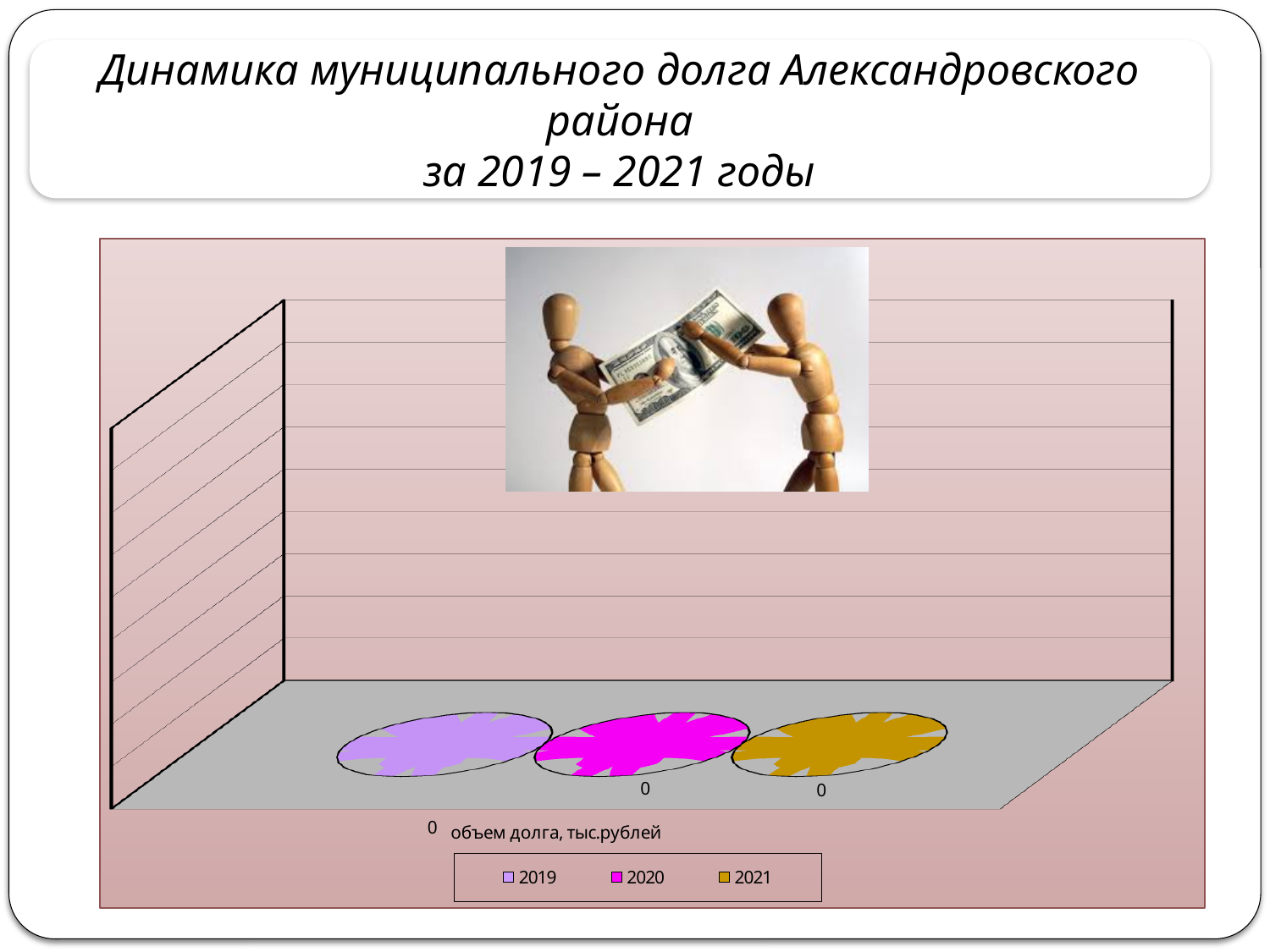
What is the value for the 2019 series in the chart? 0 What is the value for the 2020 series in the chart? 0 What kind of chart is shown on the slide? bar chart How many series does the legend list? 3 What is the value for the 2021 series in the chart? 0 What is the difference between the values for 2021 and 2020? 0 Which series is shown in magenta in the legend? 2020 What is the label of the category on the x axis? объем долга, тыс.рублей How many categories are shown on the x axis of the chart? 1 What is the difference between the values for 2020 and 2019? 0